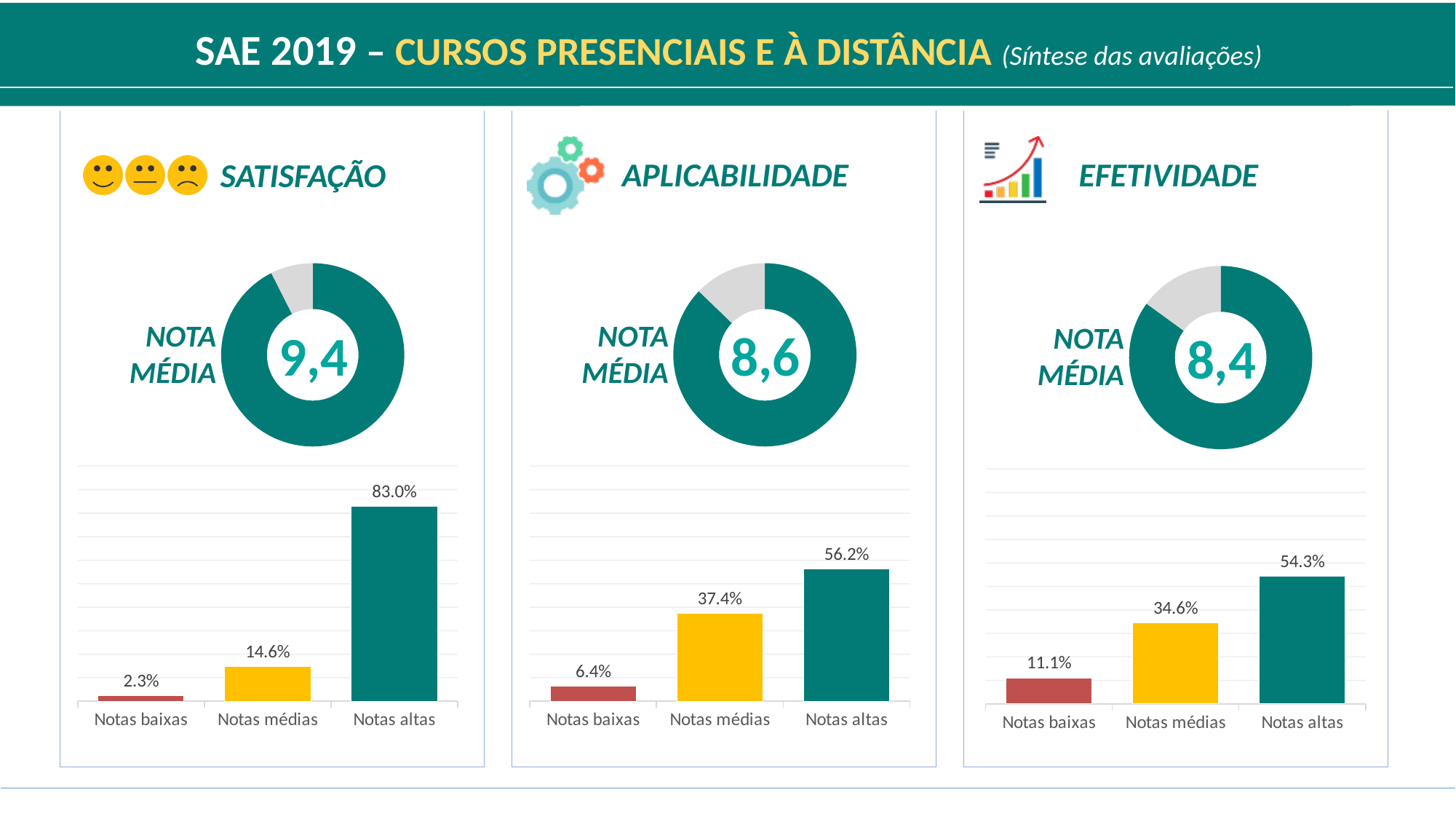
In the SATISFAÇÃO bar chart, which category has the lowest value? Notas baixas In the SATISFAÇÃO bar chart, what is the value for Notas altas? 83.0% How many categories does the EFETIVIDADE bar chart show? 3 What is the NOTA MÉDIA shown in the APLICABILIDADE donut chart? 8,6 What kind of chart is used below the NOTA MÉDIA donut in each panel? Bar chart In the EFETIVIDADE bar chart, which category has the highest value? Notas altas In the EFETIVIDADE bar chart, what is the value for Notas baixas? 11.1% In the SATISFAÇÃO bar chart, what is the difference between Notas altas and Notas baixas? 80.7% In the APLICABILIDADE bar chart, what is the value for Notas médias? 37.4% In the APLICABILIDADE bar chart, what is the difference between Notas altas and Notas médias? 18.8% Which is larger: Notas médias in the APLICABILIDADE bar chart or Notas médias in the EFETIVIDADE bar chart? APLICABILIDADE (37.4%) In the EFETIVIDADE bar chart, do the values rise or fall from Notas baixas to Notas altas? Rise